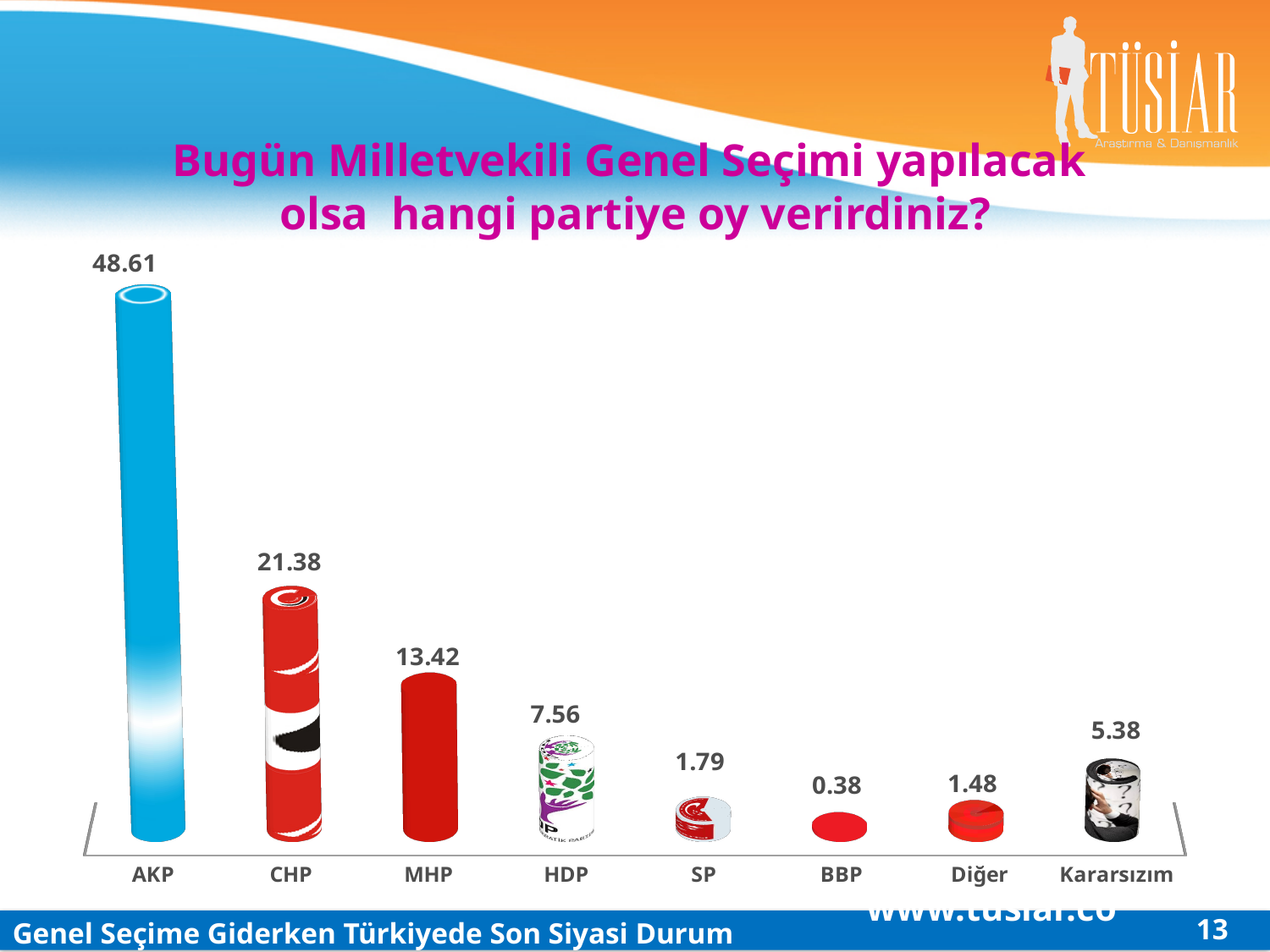
How many categories are shown on the x axis? 8 Which is larger, the value for SP or the value for Diğer? SP What is the difference between the values for MHP and HDP? 5.86 What is the value for AKP? 48.61 What is the value for Kararsızım? 5.38 Which category has the highest value? AKP What is the title of the chart? Bugün Milletvekili Genel Seçimi yapılacak olsa hangi partiye oy verirdiniz? What is the value for CHP? 21.38 Which category has the lowest value? BBP What kind of chart is shown on the slide? bar chart What is the difference between the values for AKP and CHP? 27.23 What is the value for HDP? 7.56